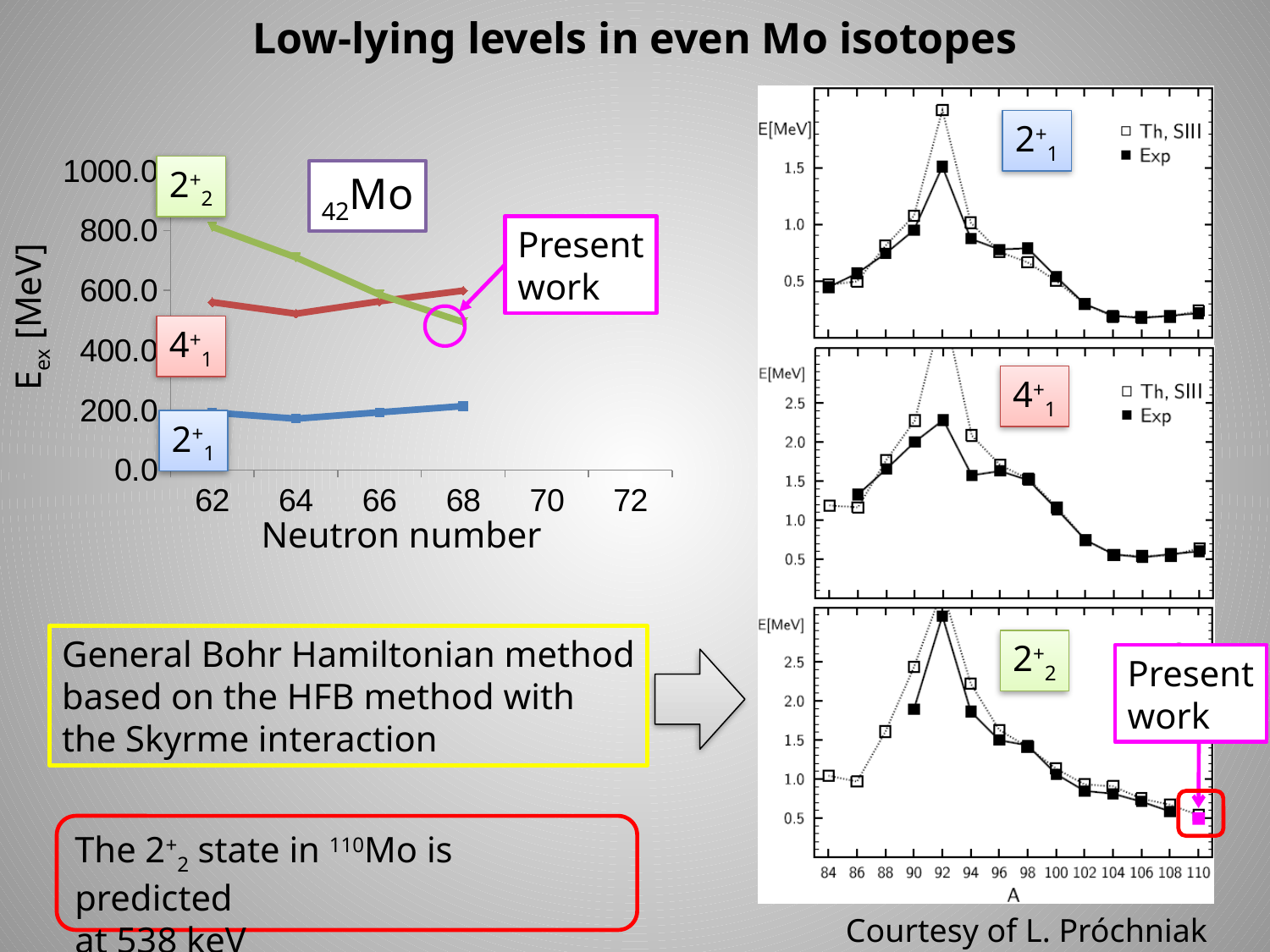
In the left-hand chart, is the 2+1 value at neutron number 68 greater or less than 400? less In the right-hand 2+1 chart, at which mass number A does the Exp series reach its highest value? 92 In the left-hand chart, how many neutron-number points does each series have? 4 In the left-hand chart, which series has the lowest values across all neutron numbers? 2+1 What kind of chart is the left-hand chart of E_ex versus neutron number? line chart What two series does the legend of the right-hand charts list? Th, SIII and Exp In the right-hand 4+1 chart, is the Exp value at A = 104 greater or less than 1.0 MeV? less In the left-hand chart, is the 2+2 value at neutron number 68 greater or less than 600? less In the left-hand chart, does the 2+2 series rise or fall as the neutron number increases from 62 to 68? fall In the left-hand chart, how many series (levels) are plotted? 3 In the left-hand chart, at neutron number 62, which is larger: the 2+2 value or the 4+1 value? 2+2